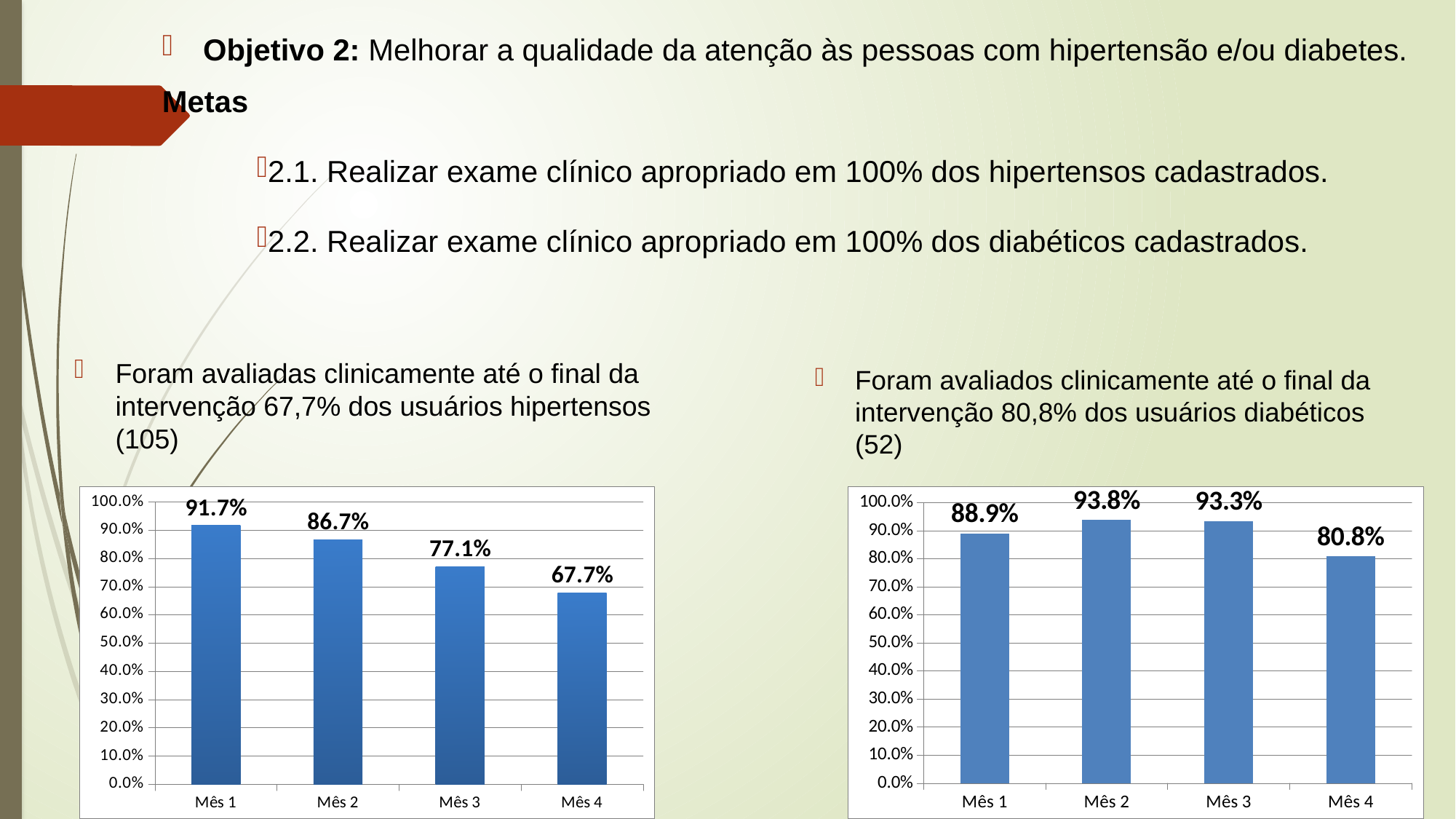
In the right chart, what is the value for Mês 2? 93.8% In the left chart, do the values rise or fall from Mês 1 to Mês 4? fall In the right chart, which month has the lowest value? Mês 4 In the left chart, what is the value for Mês 1? 91.7% What kind of chart is the right chart? bar chart In the left chart, what is the value for Mês 4? 67.7% In the left chart, which month has the highest value? Mês 1 In the left chart, what is the difference between the values for Mês 1 and Mês 4? 24.0% In the right chart, what is the value for Mês 4? 80.8% In the right chart, what is the difference between the values for Mês 2 and Mês 4? 13.0% How many categories are shown on the x axis of the left chart? 4 In the right chart, which is larger, the value for Mês 1 or the value for Mês 4? Mês 1